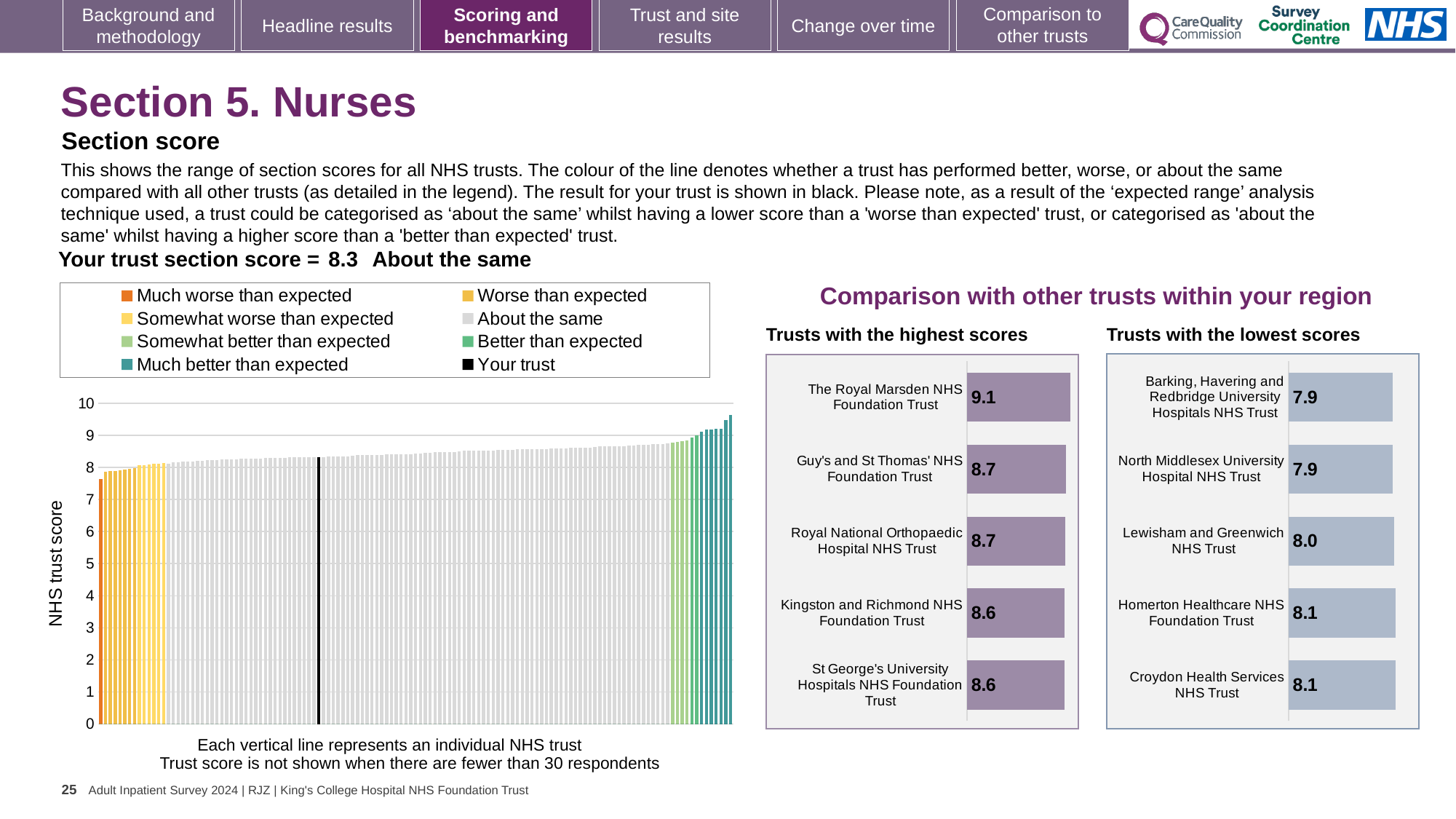
How many trusts are shown in the 'Trusts with the highest scores' chart? 5 How many entries does the legend of the large chart on the left list? 8 In the large chart on the left, is the value for the black 'Your trust' bar greater or less than 9? less In the 'Trusts with the highest scores' chart, which trust has the highest score? The Royal Marsden NHS Foundation Trust In the 'Trusts with the lowest scores' chart, which is larger: the score for Homerton Healthcare NHS Foundation Trust or Lewisham and Greenwich NHS Trust? Homerton Healthcare NHS Foundation Trust In the 'Trusts with the highest scores' chart, what is the score for Kingston and Richmond NHS Foundation Trust? 8.6 In the 'Trusts with the highest scores' chart, what is the difference between the scores of The Royal Marsden NHS Foundation Trust and St George's University Hospitals NHS Foundation Trust? 0.5 What kind of chart is the large chart on the left showing NHS trust scores? Bar chart In the 'Trusts with the lowest scores' chart, what is the score for Lewisham and Greenwich NHS Trust? 8.0 In the 'Trusts with the lowest scores' chart, what is the score for North Middlesex University Hospital NHS Trust? 7.9 In the 'Trusts with the lowest scores' chart, what is the difference between the scores of Croydon Health Services NHS Trust and Barking, Havering and Redbridge University Hospitals NHS Trust? 0.2 In the 'Trusts with the highest scores' chart, what is the score for The Royal Marsden NHS Foundation Trust? 9.1